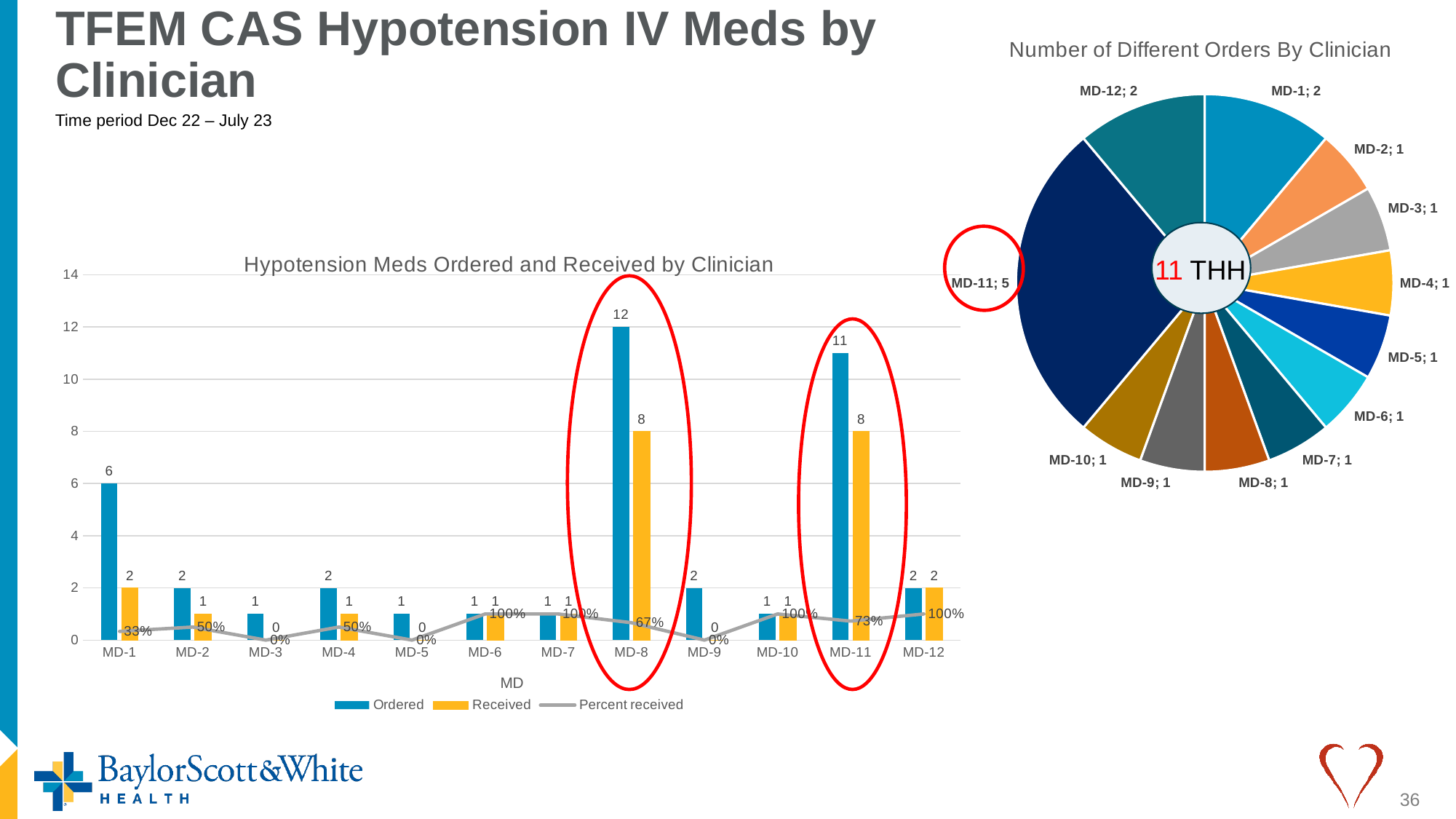
In the 'Number of Different Orders By Clinician' pie chart, how many slices are there? 12 In the 'Hypotension Meds Ordered and Received by Clinician' chart, how many meds were ordered by MD-8? 12 In the 'Hypotension Meds Ordered and Received by Clinician' chart, which clinician has the highest number of meds ordered? MD-8 In the 'Hypotension Meds Ordered and Received by Clinician' chart, what is the percent received for MD-11? 73% In the 'Hypotension Meds Ordered and Received by Clinician' chart, which is larger: meds ordered by MD-8 or meds ordered by MD-11? MD-8 What kind of chart is 'Number of Different Orders By Clinician'? Pie chart In the 'Hypotension Meds Ordered and Received by Clinician' chart, how many clinicians are shown on the x axis? 12 What text is shown in the centre of the 'Number of Different Orders By Clinician' pie chart? 11 THH In the 'Number of Different Orders By Clinician' pie chart, how many different orders does MD-11 have? 5 How many series does the legend of the 'Hypotension Meds Ordered and Received by Clinician' chart list? 3 In the 'Hypotension Meds Ordered and Received by Clinician' chart, what is the difference between meds ordered and meds received for MD-1? 4 In the 'Number of Different Orders By Clinician' pie chart, which clinician has the largest slice? MD-11